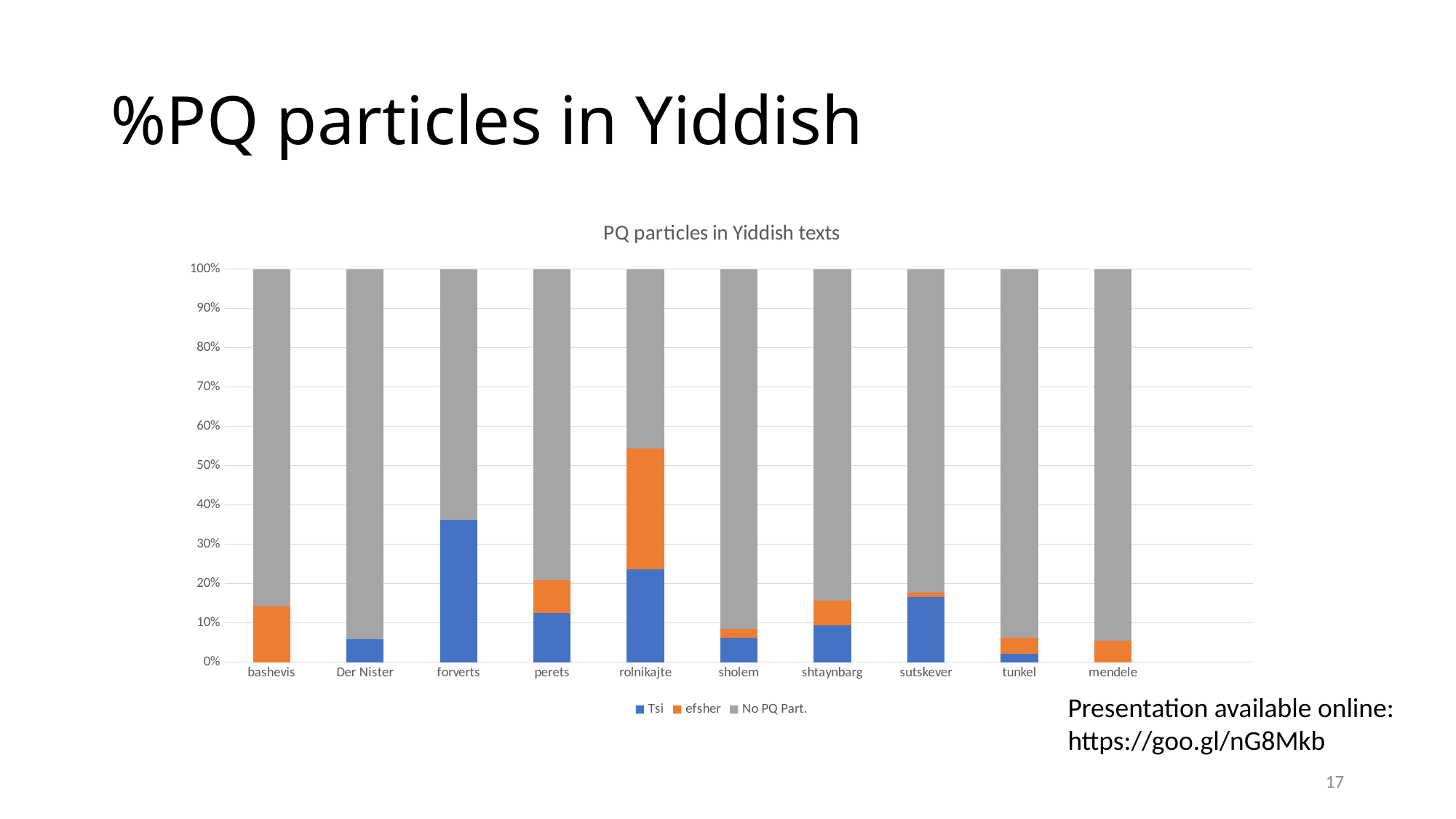
Which has a larger Tsi share, perets or sutskever? sutskever Which text has the highest share of Tsi? forverts Is the efsher share for rolnikajte greater or less than 20%? greater What is the title of the chart? PQ particles in Yiddish texts Which text has the lowest share of No PQ Part.? rolnikajte What kind of chart is shown on the slide? stacked bar chart How many series does the chart's legend list? 3 What is the total height of the stacked bar for bashevis? 100% Which text has the highest share of efsher? rolnikajte Is the No PQ Part. share for rolnikajte greater or less than 60%? less How many texts (categories) are shown on the x axis of the chart? 10 Is the Tsi share for forverts greater or less than 30%? greater